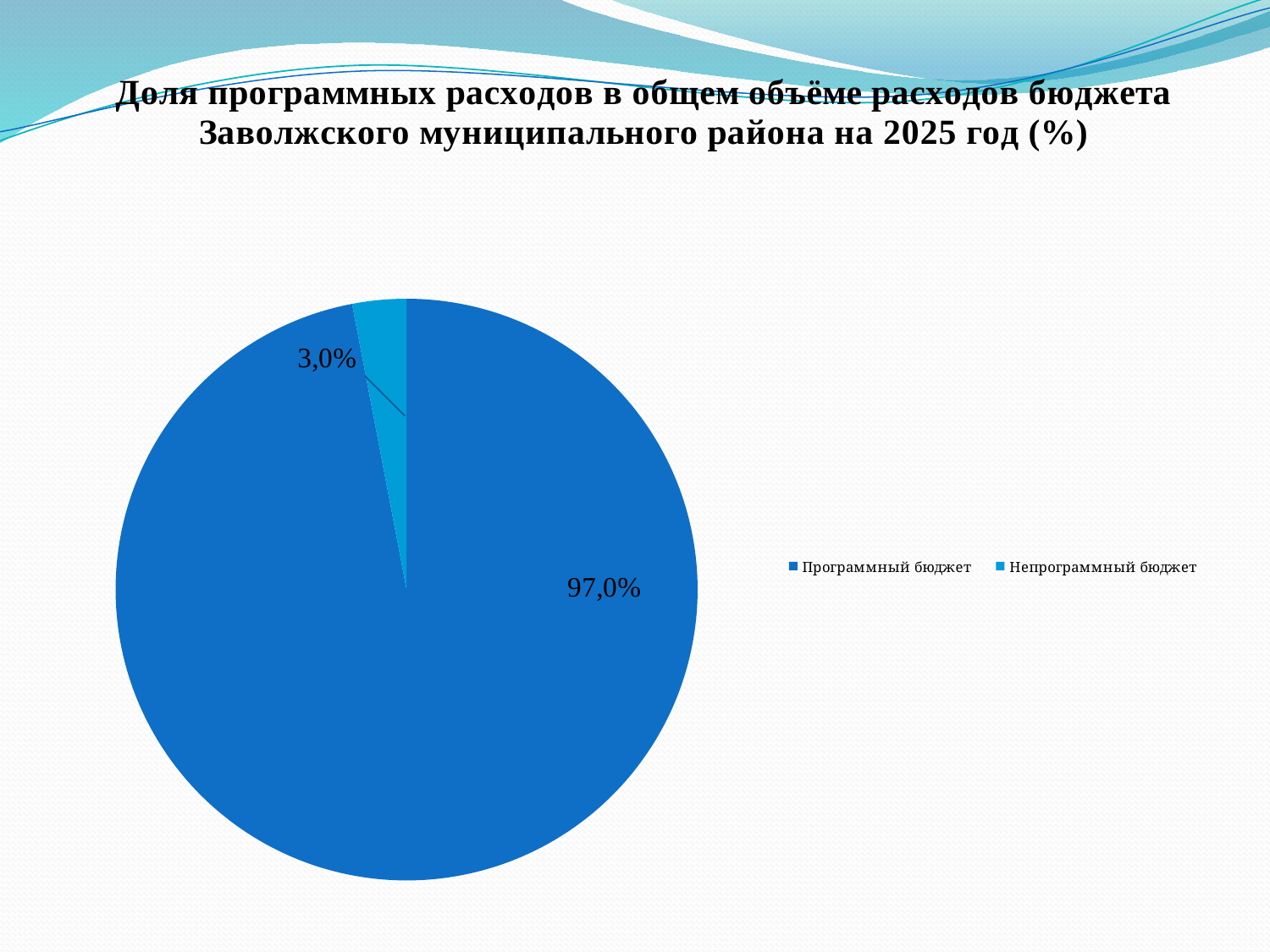
Which category has the largest slice of the pie? Программный бюджет What kind of chart is shown on the slide? pie chart What is the value for Непрограммный бюджет? 3,0% What is the title of the chart on the slide? Доля программных расходов в общем объёме расходов бюджета Заволжского муниципального района на 2025 год (%) What is the difference between the values for Программный бюджет and Непрограммный бюджет? 94,0% What is the value for Программный бюджет? 97,0% What share of the pie does Непрограммный бюджет take? 3,0% Which legend entry is shown in the lighter blue colour? Непрограммный бюджет Which category has the smallest slice of the pie? Непрограммный бюджет How many slices does the pie chart have? 2 Which is larger, Программный бюджет or Непрограммный бюджет? Программный бюджет How many entries does the legend list? 2